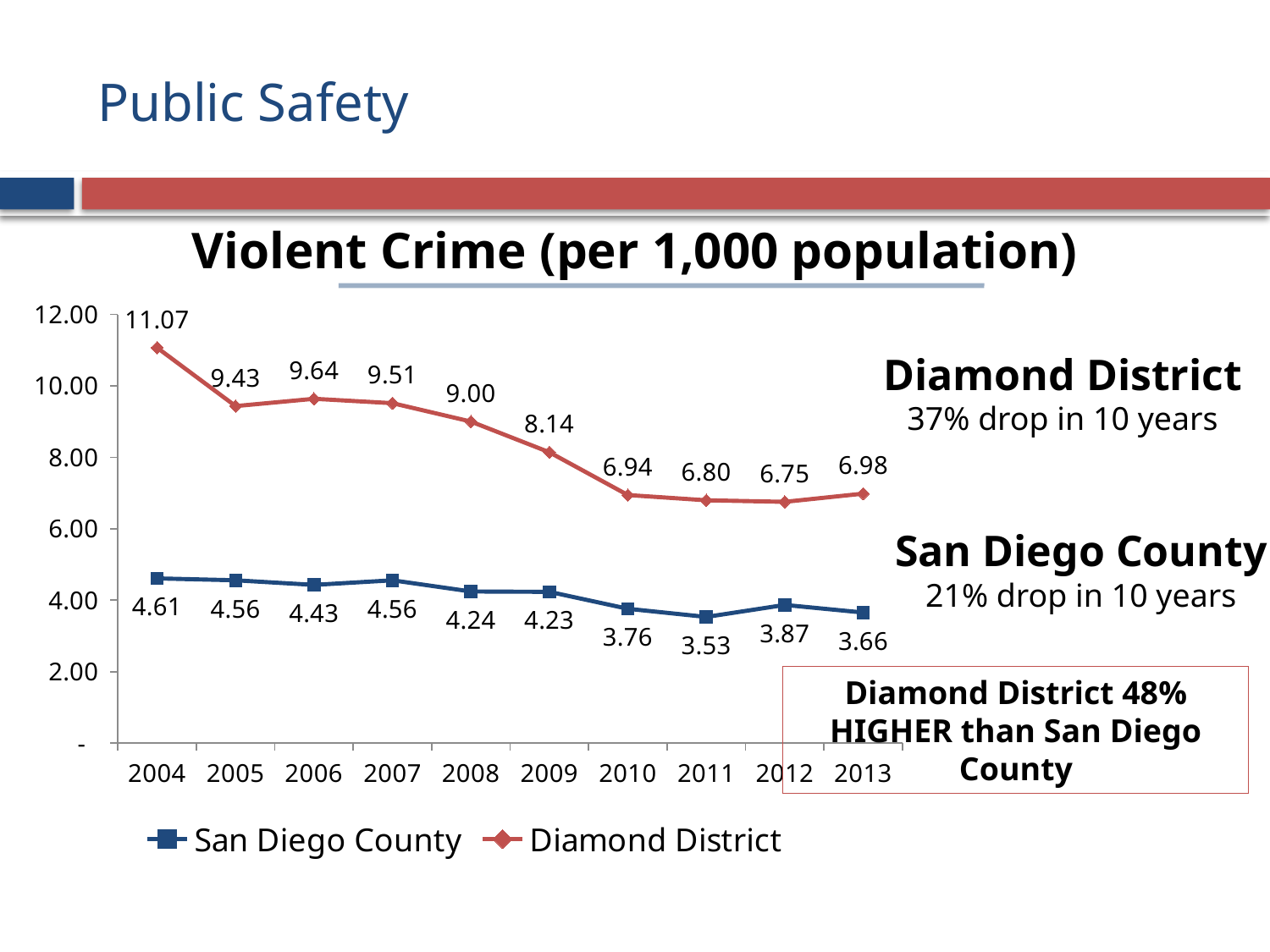
Which series has the larger value in 2008, Diamond District or San Diego County? Diamond District What kind of chart is shown? Line chart What is the San Diego County violent crime rate in 2011? 3.53 In which year is the Diamond District value highest? 2004 In which year is the Diamond District value lowest? 2012 What is the difference between the Diamond District and San Diego County values in 2013? 3.32 In which year is the San Diego County value lowest? 2011 What is the Diamond District violent crime rate in 2004? 11.07 Does the Diamond District series generally rise or fall from 2004 to 2013? Fall How many years are shown on the x axis? 10 What is the Diamond District value for 2009? 8.14 How many series does the legend list? 2